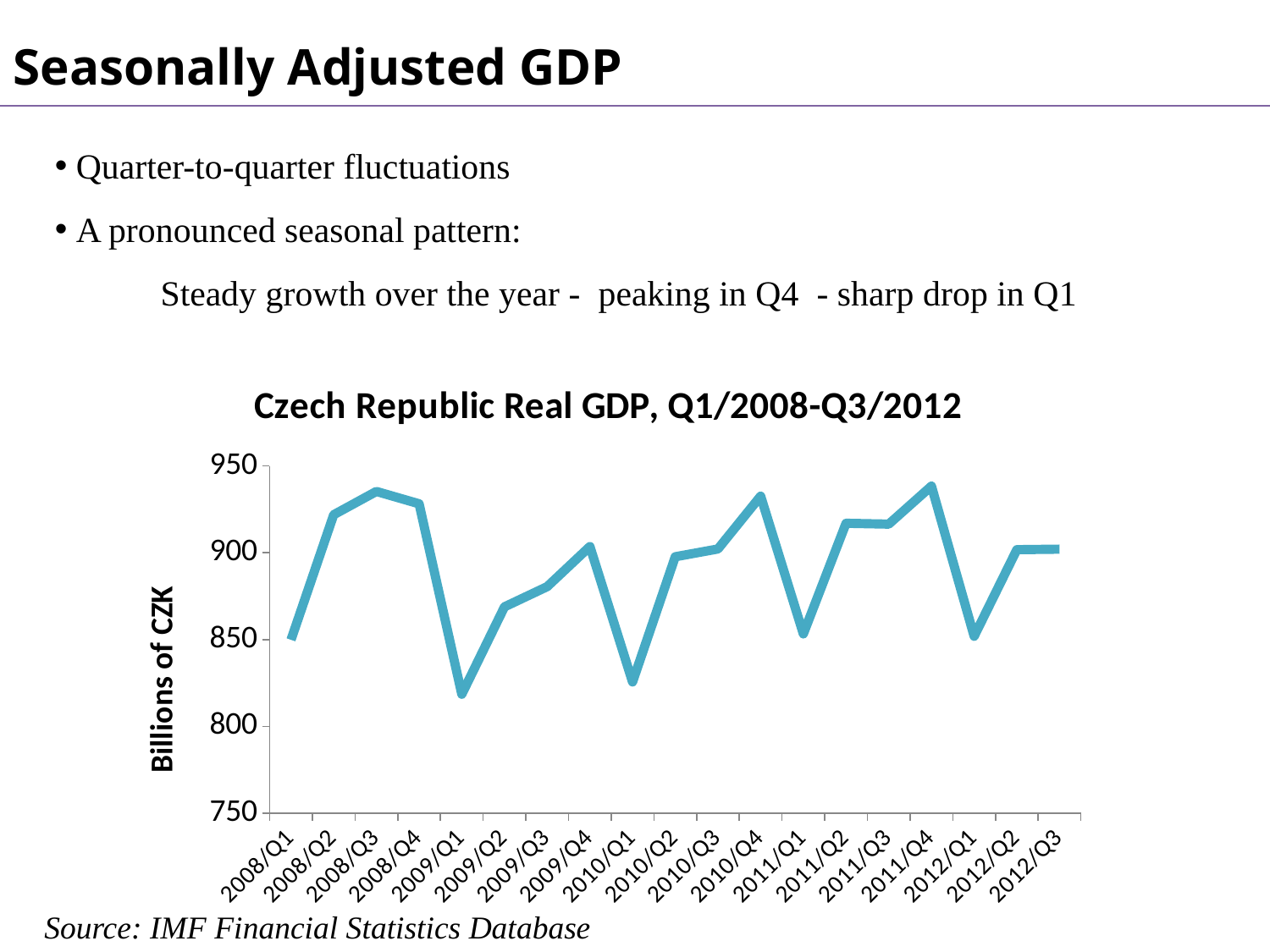
Is the value for 2009/Q2 greater or less than 850? greater Is the value for 2008/Q3 greater or less than 900? greater Is the value for 2010/Q1 greater or less than 850? less Which is larger, the value for 2008/Q2 or the value for 2009/Q2? 2008/Q2 How many quarters are plotted on the x axis of the chart? 19 What kind of chart is shown on the slide? line chart Which is larger, the value for 2010/Q1 or the value for 2010/Q4? 2010/Q4 What is the title of the chart? Czech Republic Real GDP, Q1/2008-Q3/2012 What is the label on the vertical axis of the chart? Billions of CZK Do the values rise or fall from 2009/Q1 to 2009/Q4? rise